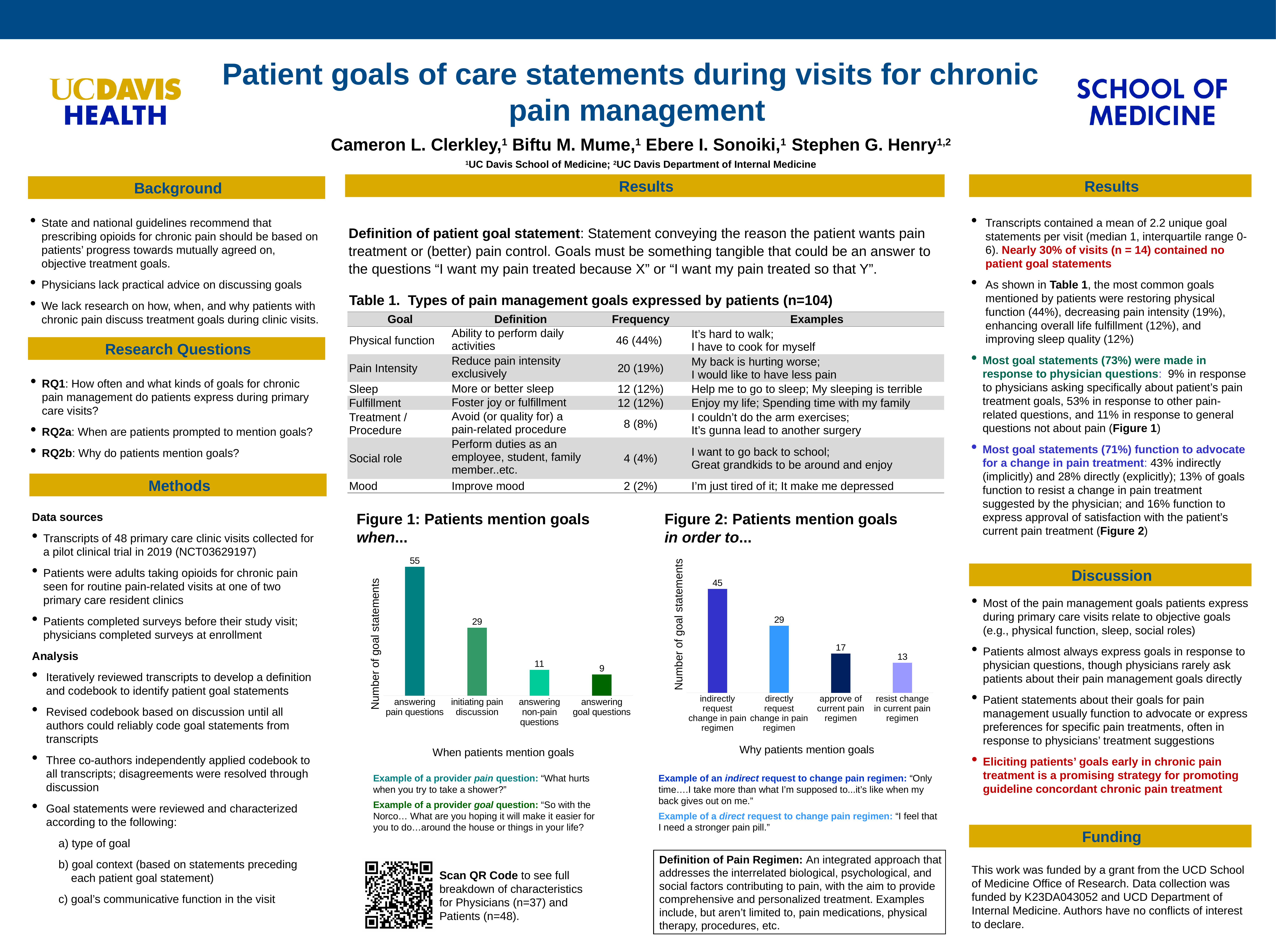
In Figure 1 (Patients mention goals when...), which category has the lowest number of goal statements? answering goal questions In Figure 2 (Patients mention goals in order to...), how many goal statements resist change in current pain regimen? 13 In Figure 2 (Patients mention goals in order to...), how many goal statements indirectly request a change in pain regimen? 45 In Figure 2 (Patients mention goals in order to...), which is larger: approve of current pain regimen or resist change in current pain regimen? approve of current pain regimen In Figure 1 (Patients mention goals when...), how many categories are shown on the x axis? 4 In Figure 1 (Patients mention goals when...), how many goal statements were made when initiating pain discussion? 29 In Figure 1 (Patients mention goals when...), what is the difference between the number of goal statements for answering pain questions and initiating pain discussion? 26 In Figure 2 (Patients mention goals in order to...), which category has the highest number of goal statements? indirectly request change in pain regimen In Figure 1 (Patients mention goals when...), what is the label of the y axis? Number of goal statements In Figure 1 (Patients mention goals when...), how many goal statements were made when answering pain questions? 55 What type of chart is Figure 2 (Patients mention goals in order to...)? bar chart In Figure 2 (Patients mention goals in order to...), what is the difference between directly request change in pain regimen and approve of current pain regimen? 12